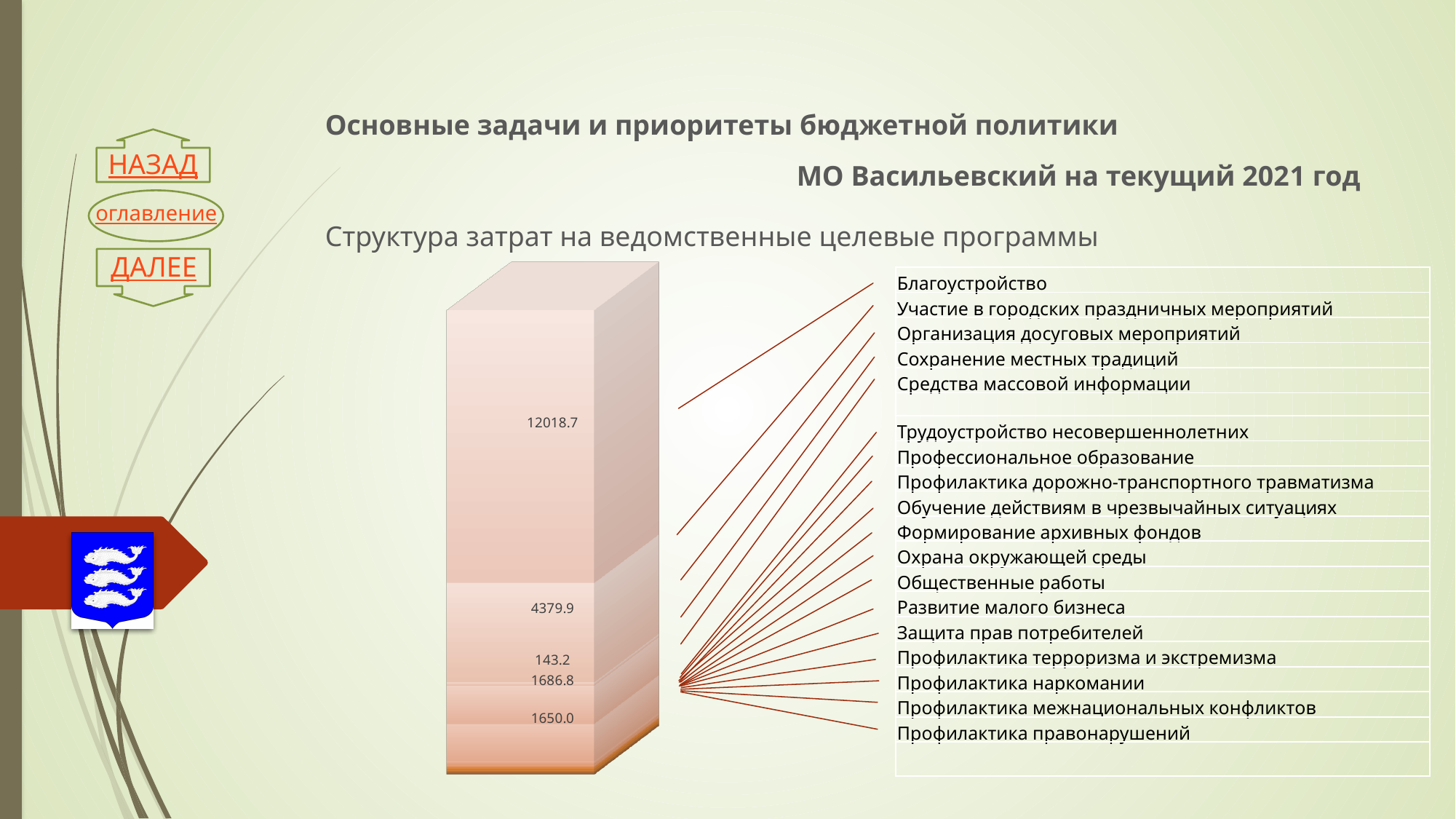
What is the largest value labelled on the stacked bar? 12018.7 Which is larger: the segment labelled 1686.8 or the segment labelled 1650.0? 1686.8 What is the title of the chart on the slide? Структура затрат на ведомственные целевые программы How many segments of the stacked bar have a printed data label? 5 What is the value of the second-largest labelled segment of the bar? 4379.9 What kind of chart is shown on the slide? stacked bar chart How many entries does the chart's legend list? 18 What is the difference between the segments labelled 1686.8 and 1650.0? 36.8 What is the first entry listed in the chart's legend? Благоустройство What is the smallest value labelled on the stacked bar? 143.2 What is the value of the top (largest) segment of the bar, which is linked to Благоустройство? 12018.7 What is the difference between the segment labelled 12018.7 and the segment labelled 4379.9? 7638.8